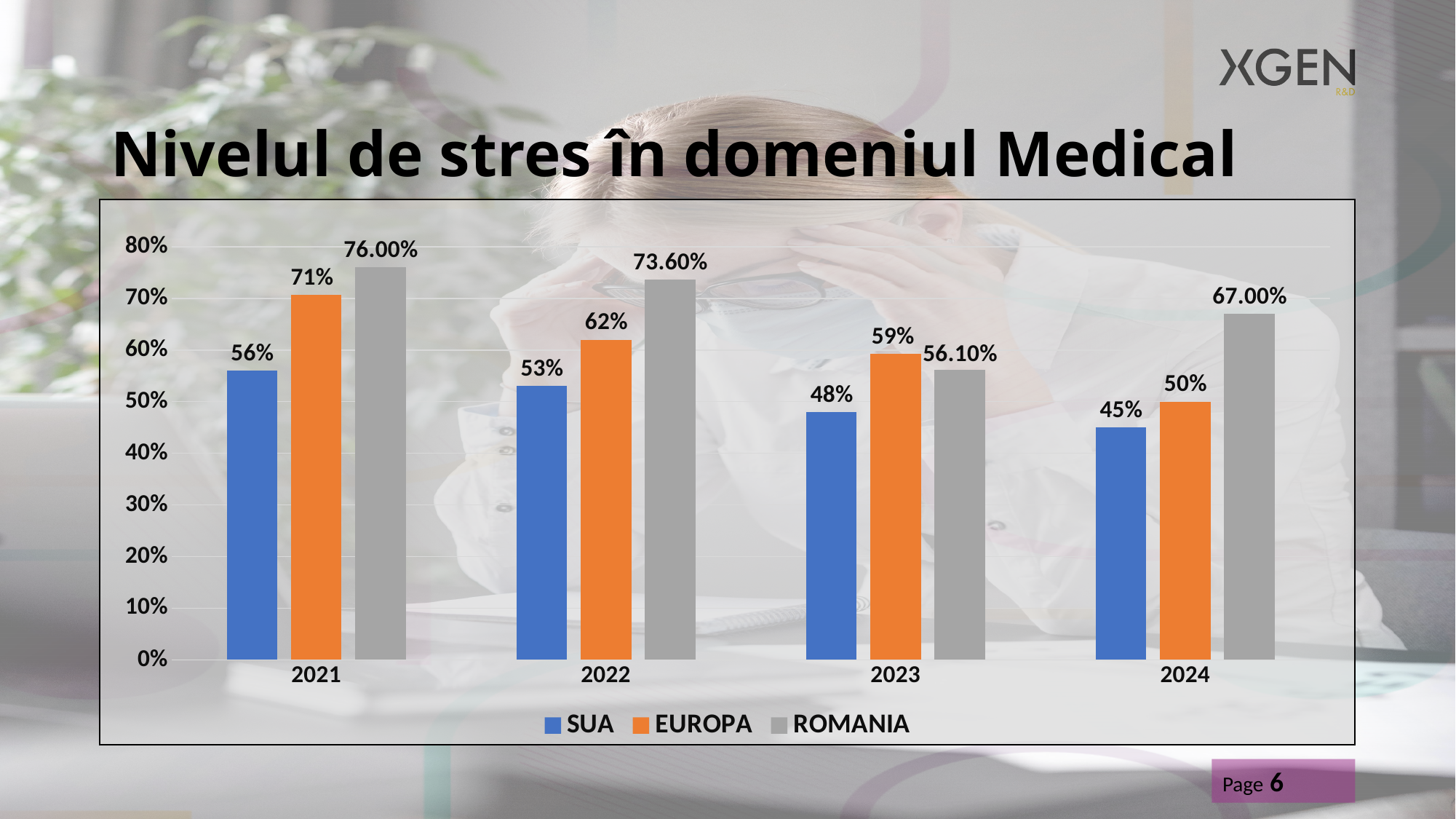
What kind of chart is shown on the slide? Bar chart What is the value for ROMANIA in 2022? 73.60% What is the value for ROMANIA in 2024? 67.00% How many series does the legend list? 3 What is the difference between the EUROPA value in 2021 and the EUROPA value in 2024? 21% Does the value for SUA rise or fall from 2021 to 2024? Fall Which is larger in 2023: the value for EUROPA or the value for ROMANIA? EUROPA How many years are shown on the x axis? 4 What is the value for EUROPA in 2023? 59% What is the value for SUA in 2021? 56% Which year has the highest value for ROMANIA? 2021 Which year has the lowest value for SUA? 2024